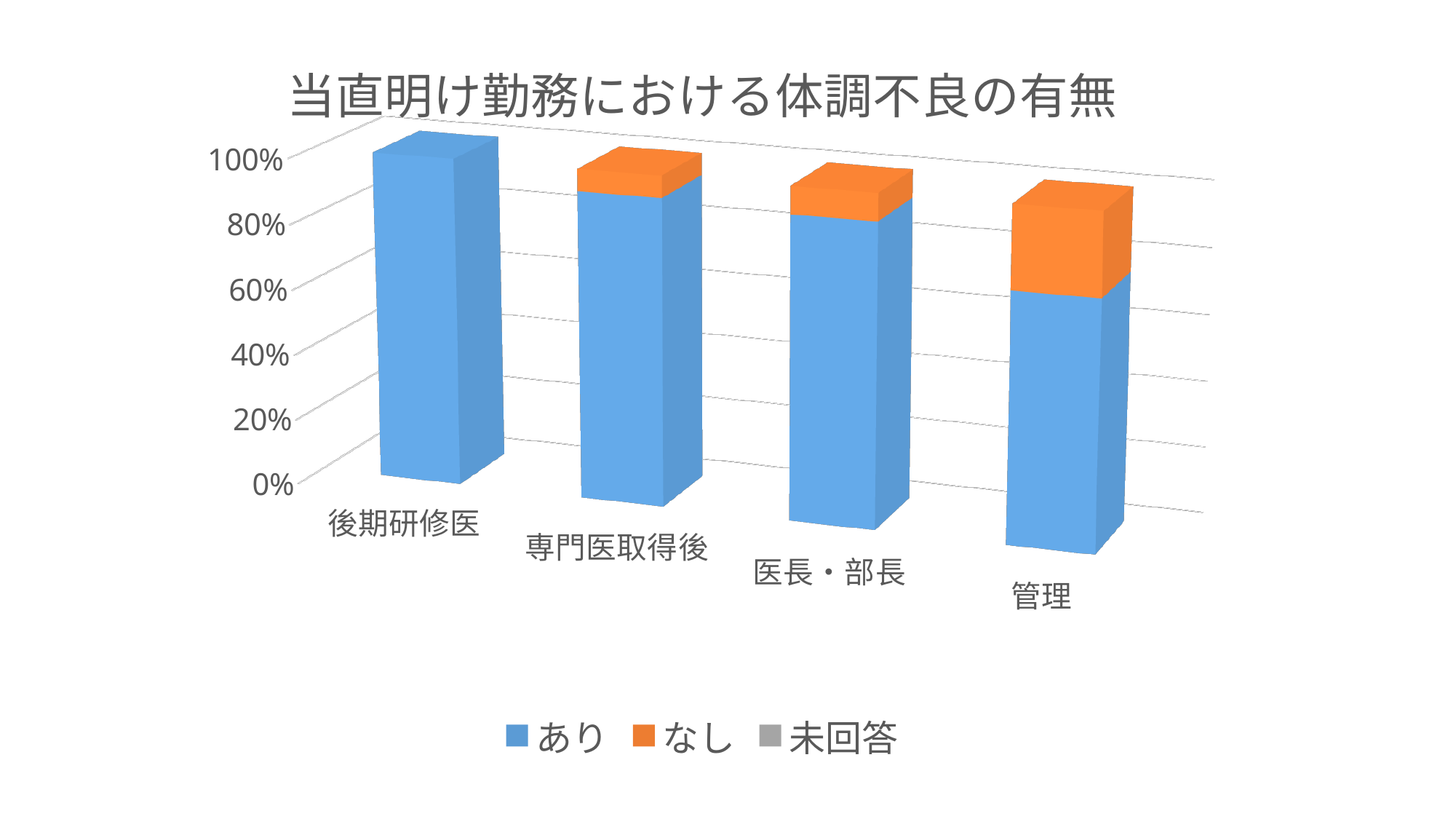
Which has a larger share of なし, 管理 or 医長・部長? 管理 Is the あり share for 管理 greater or less than 40%? greater Which colour represents なし in the legend? Orange How many series does the legend list? 3 What is the title of the chart? 当直明け勤務における体調不良の有無 Is the あり share for 専門医取得後 greater or less than 60%? greater Does the share of あり rise or fall from 後期研修医 to 管理 along the x axis? fall Which category has the lowest share of あり? 管理 Which category has the largest share of なし? 管理 What kind of chart is shown on the slide? Stacked bar chart How many categories are shown on the x axis? 4 Which category has the highest share of あり? 後期研修医